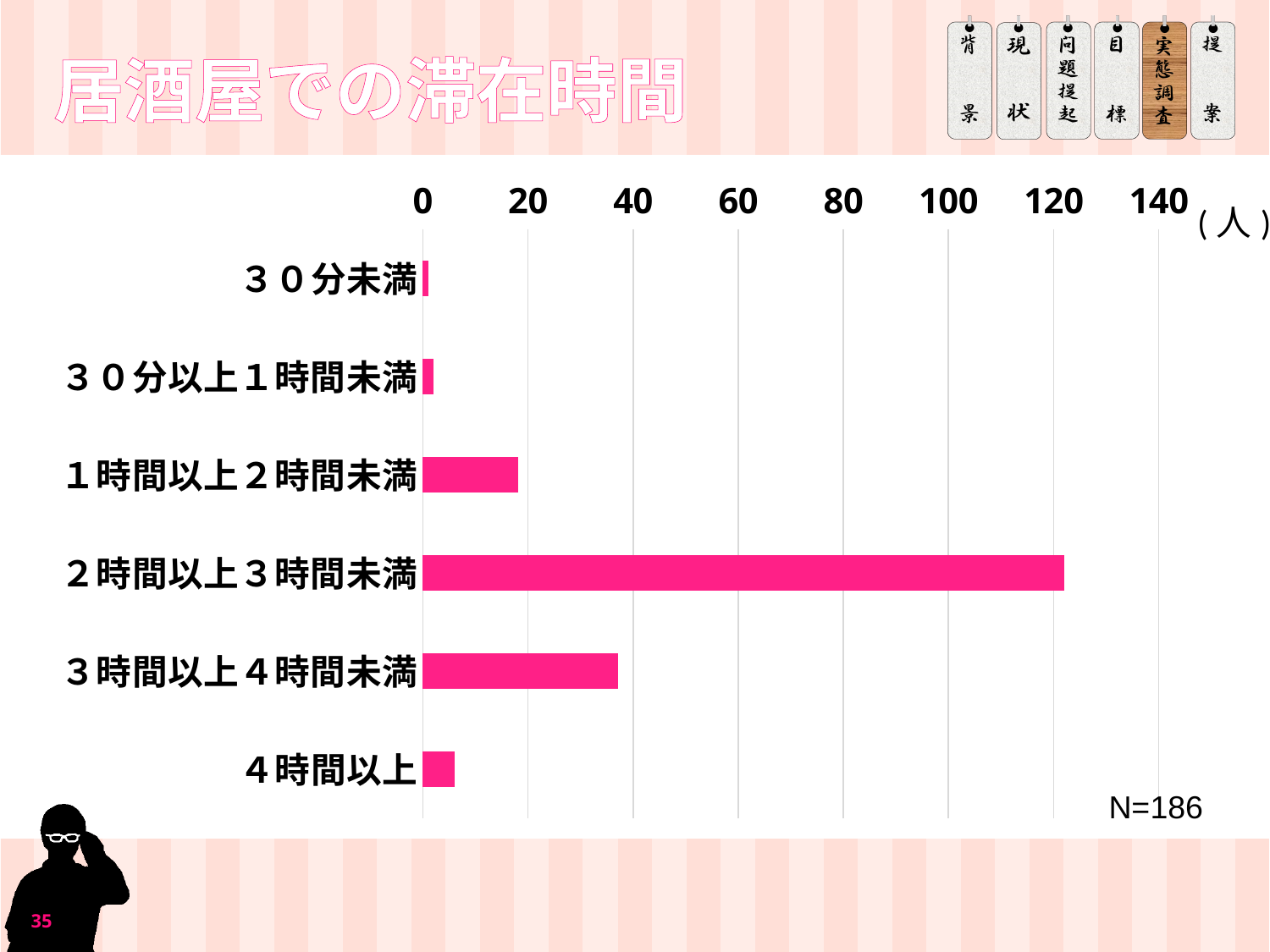
Is the value for ４時間以上 greater or less than 20? less Is the value for １時間以上２時間未満 greater or less than 20? less What is the title of the chart on the slide? 居酒屋での滞在時間 Which is larger, the value for ４時間以上 or the value for ３時間以上４時間未満? ３時間以上４時間未満 Which is larger, the value for １時間以上２時間未満 or the value for ４時間以上? １時間以上２時間未満 Is the value for ２時間以上３時間未満 greater or less than 120? greater Which is larger, the value for ３時間以上４時間未満 or the value for １時間以上２時間未満? ３時間以上４時間未満 What kind of chart is shown on the slide? bar chart What sample size (N) is shown on the chart? N=186 Which category has the highest value in the chart? ２時間以上３時間未満 How many categories are plotted in the chart? 6